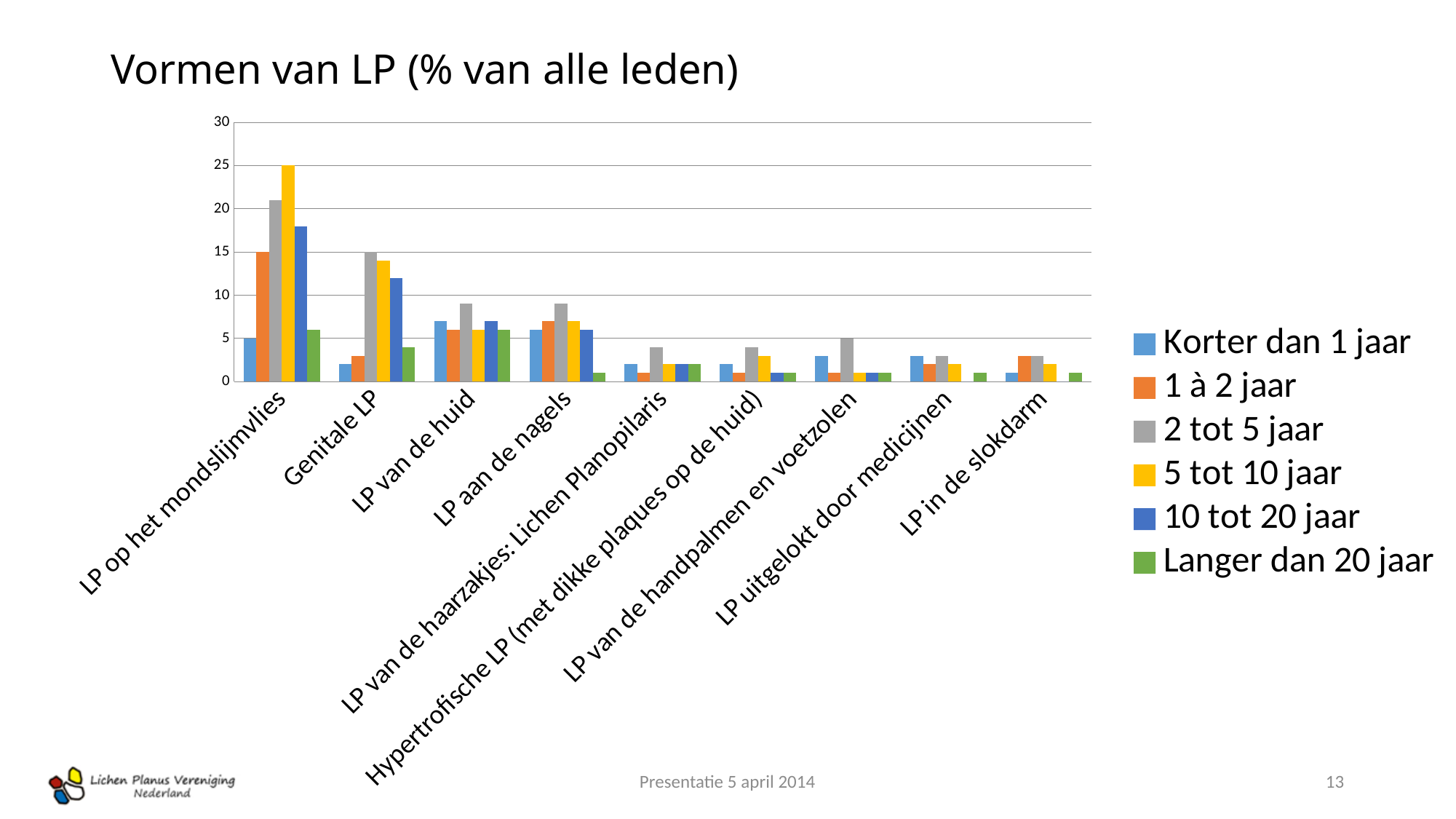
How many categories are shown on the x axis? 9 Is the value for '2 tot 5 jaar' in 'LP op het mondslijmvlies' greater or less than 20? greater Which series has the highest bar for 'LP op het mondslijmvlies'? 5 tot 10 jaar How many series does the legend list? 6 Is the value for '10 tot 20 jaar' in 'Genitale LP' greater or less than 10? greater What is the title of the chart? Vormen van LP (% van alle leden) Which series has the lowest bar for 'Genitale LP'? Korter dan 1 jaar Which category has the highest bar in the whole chart? LP op het mondslijmvlies What kind of chart is shown on the slide? bar chart Is the value for '10 tot 20 jaar' in 'LP op het mondslijmvlies' greater or less than 15? greater Which is larger: the '1 à 2 jaar' value for 'LP op het mondslijmvlies' or for 'Genitale LP'? LP op het mondslijmvlies